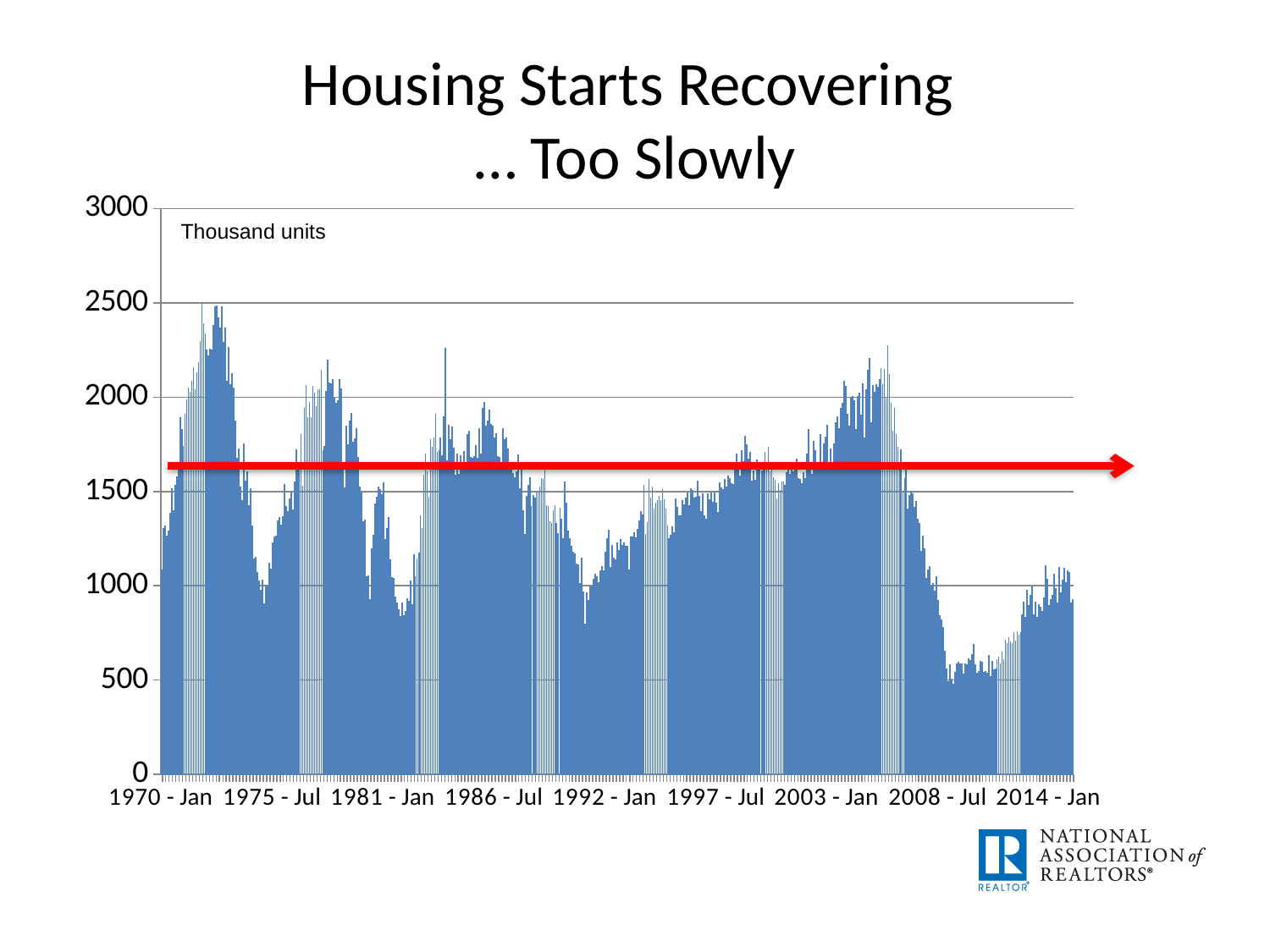
What is the highest value shown on the vertical axis? 3000 Is the value for 1975 - Jul greater or less than 1500? less Is the value for 2014 - Jan greater or less than 1500? less Which period reaches the higher peak: the early 1970s or the mid-2000s? the early 1970s Is the value for 2003 - Jan greater or less than 1500? greater What kind of chart is shown on the slide? bar chart What is the title of the chart on the slide? Housing Starts Recovering … Too Slowly What unit label is printed inside the chart area? Thousand units How many date labels are printed along the horizontal axis? 9